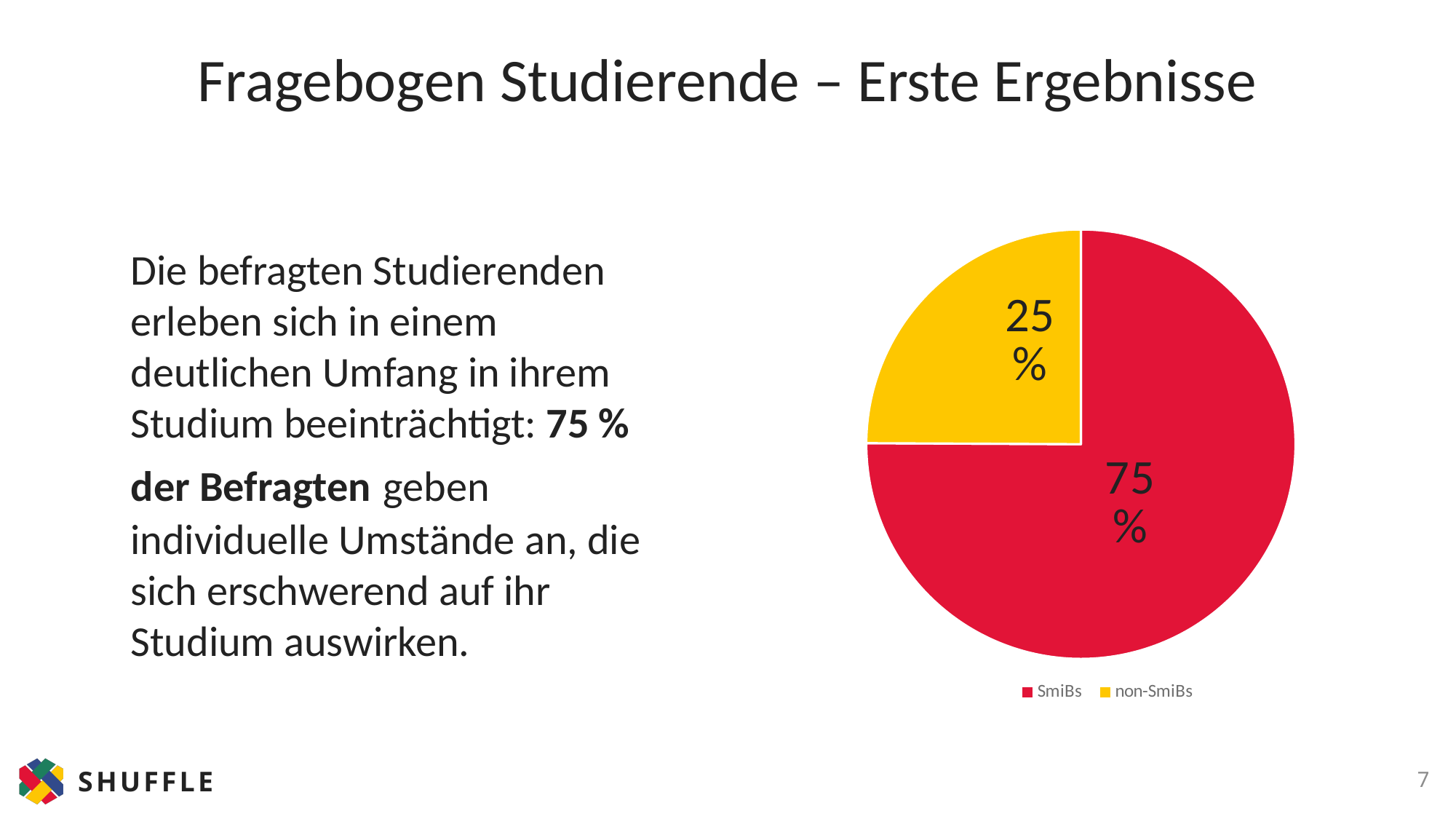
How many entries does the legend list? 2 Which slice is the largest in the pie chart? SmiBs What share of the pie does the non-SmiBs slice represent? 25% What kind of chart is shown on the slide? pie chart What percentage does the non-SmiBs slice show? 25% What is the difference in percentage points between the SmiBs and non-SmiBs slices? 50 What colour is the SmiBs slice? red Which slice is the smallest in the pie chart? non-SmiBs Which slice is larger, SmiBs or non-SmiBs? SmiBs What colour is the non-SmiBs slice? yellow What percentage does the SmiBs slice show? 75% How many slices does the pie chart have? 2